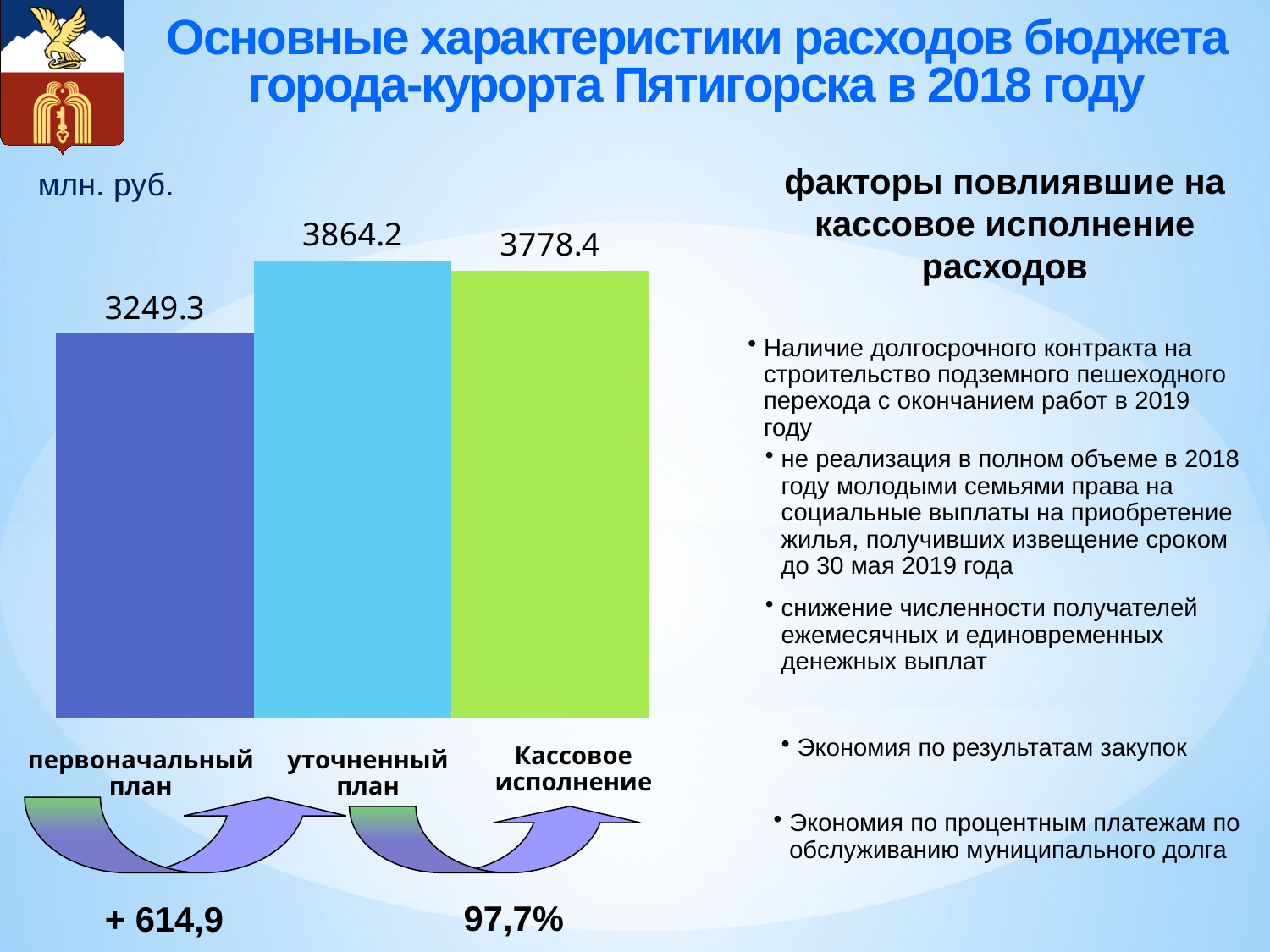
How many bars are shown in the chart? 3 Which category has the lowest value? первоначальный план What colour is the bar for Кассовое исполнение? green What is the value for уточненный план? 3864.2 What is the difference between уточненный план and Кассовое исполнение? 85.8 What is the value for первоначальный план? 3249.3 Which category has the highest value? уточненный план What unit is indicated for the chart values? млн. руб. What is the difference between уточненный план and первоначальный план? 614.9 What is the value for Кассовое исполнение? 3778.4 Which is larger, Кассовое исполнение or первоначальный план? Кассовое исполнение What kind of chart is shown on the slide? bar chart